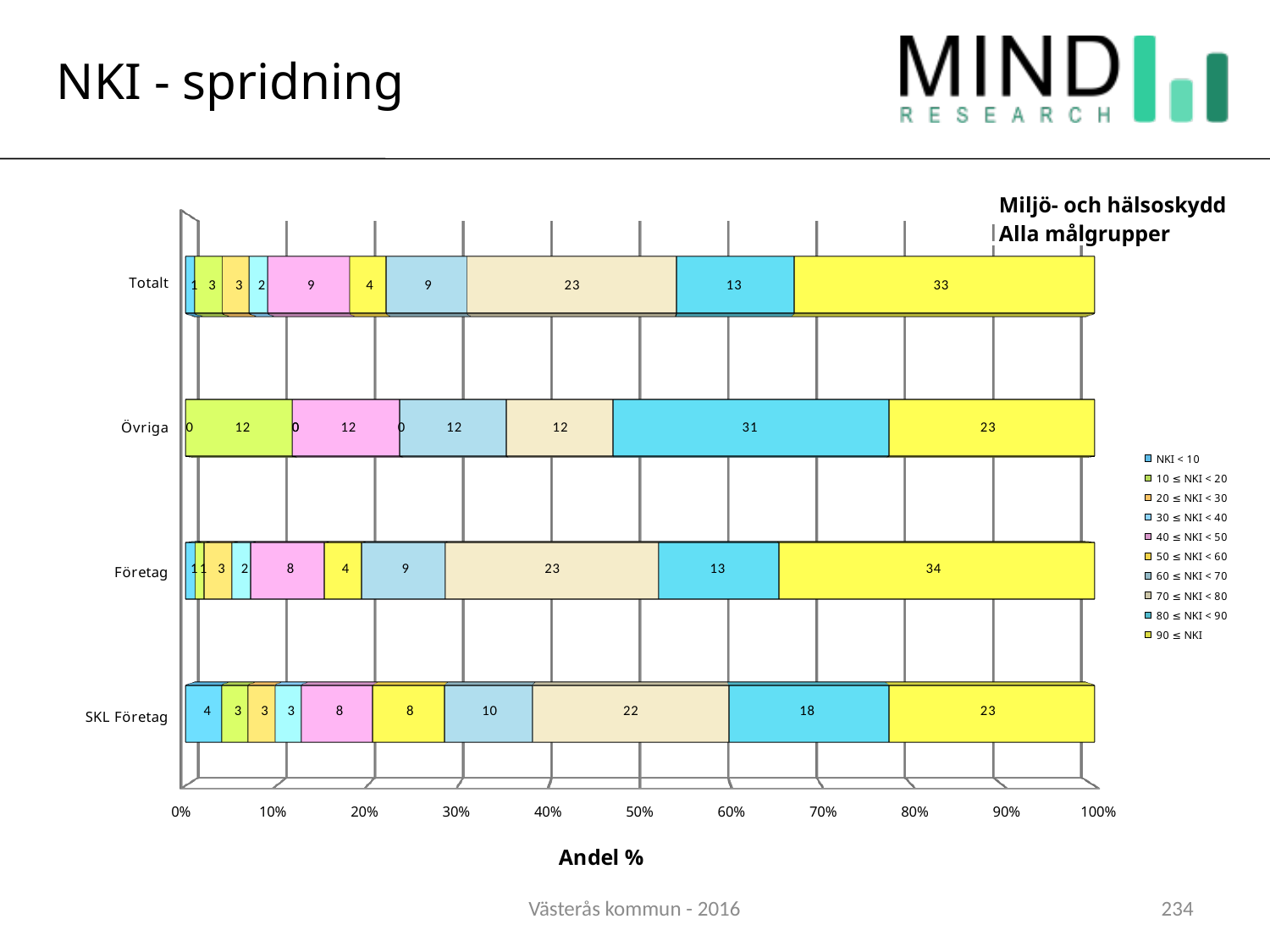
How many categories are shown on the vertical axis of the chart? 4 What is the difference between the 90 ≤ NKI segment for Företag and for SKL Företag? 11 Which category has the largest 90 ≤ NKI segment? Företag What is the value of the 90 ≤ NKI segment for Totalt? 33 What is the value of the 80 ≤ NKI < 90 segment for Övriga? 31 What is the value of the 90 ≤ NKI segment for Företag? 34 How many series does the chart legend list? 10 What kind of chart is shown on the slide? Stacked bar chart What is the value of the 70 ≤ NKI < 80 segment for SKL Företag? 22 Which is larger: the 80 ≤ NKI < 90 segment for SKL Företag or for Totalt? SKL Företag What is the label of the horizontal axis of the chart? Andel % Which category has the largest 80 ≤ NKI < 90 segment? Övriga